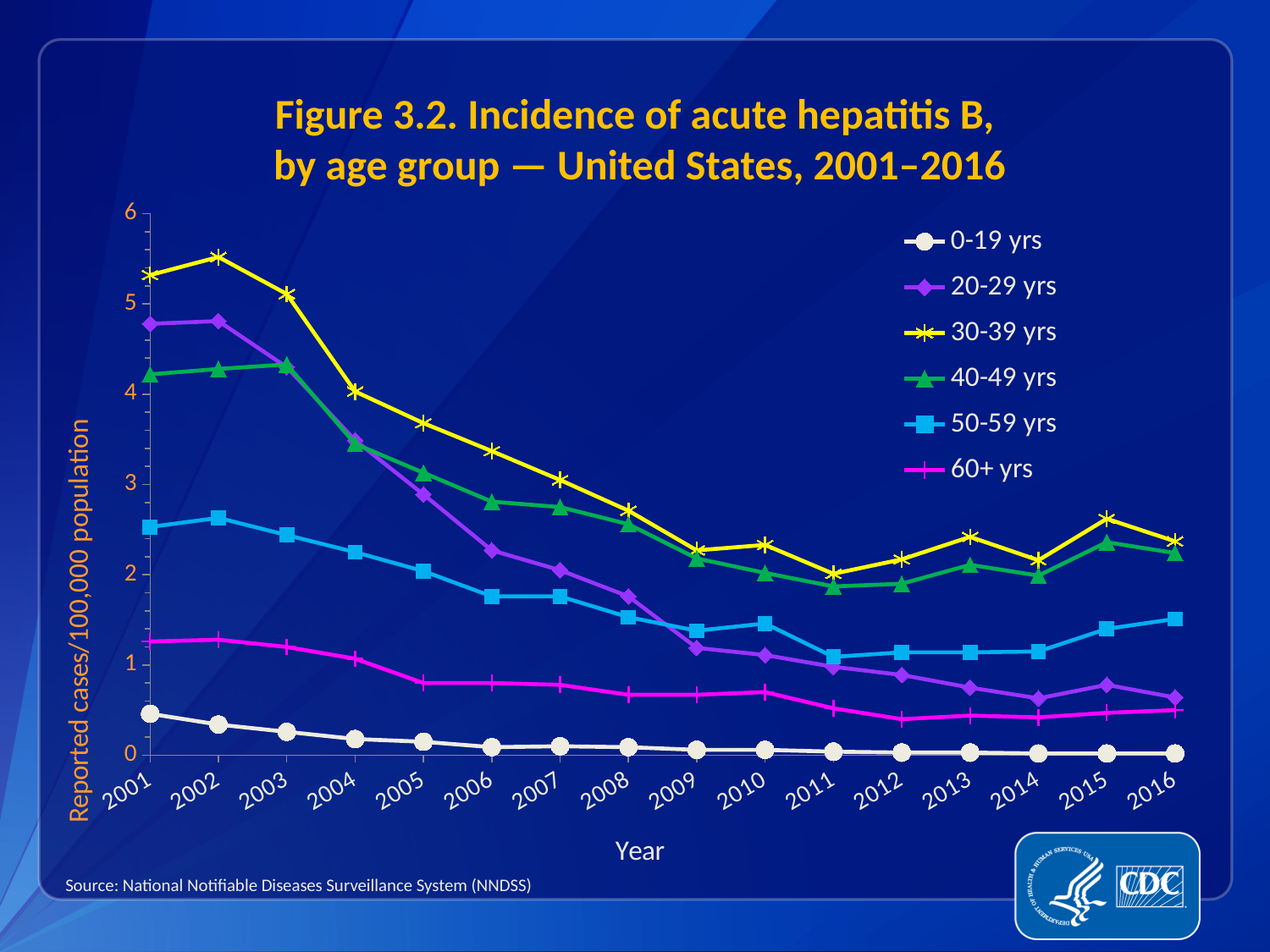
Is the value for 40-49 yrs in 2004 greater or less than 3? greater How many age-group series does the legend list? 6 How many years are plotted along the x axis? 16 Which age group had the lowest incidence of acute hepatitis B in 2001? 0-19 yrs Is the value for 0-19 yrs in 2001 greater or less than 1? less In 2001, which had the higher incidence: 20-29 yrs or 40-49 yrs? 20-29 yrs Which age group had the highest incidence of acute hepatitis B in 2002? 30-39 yrs Is the value for 30-39 yrs in 2002 greater or less than 5? greater In 2016, which had the higher incidence: 50-59 yrs or 20-29 yrs? 50-59 yrs What kind of chart is shown on the slide? Line chart Overall, does the incidence for 30-39 yrs rise or fall from 2001 to 2016? Fall